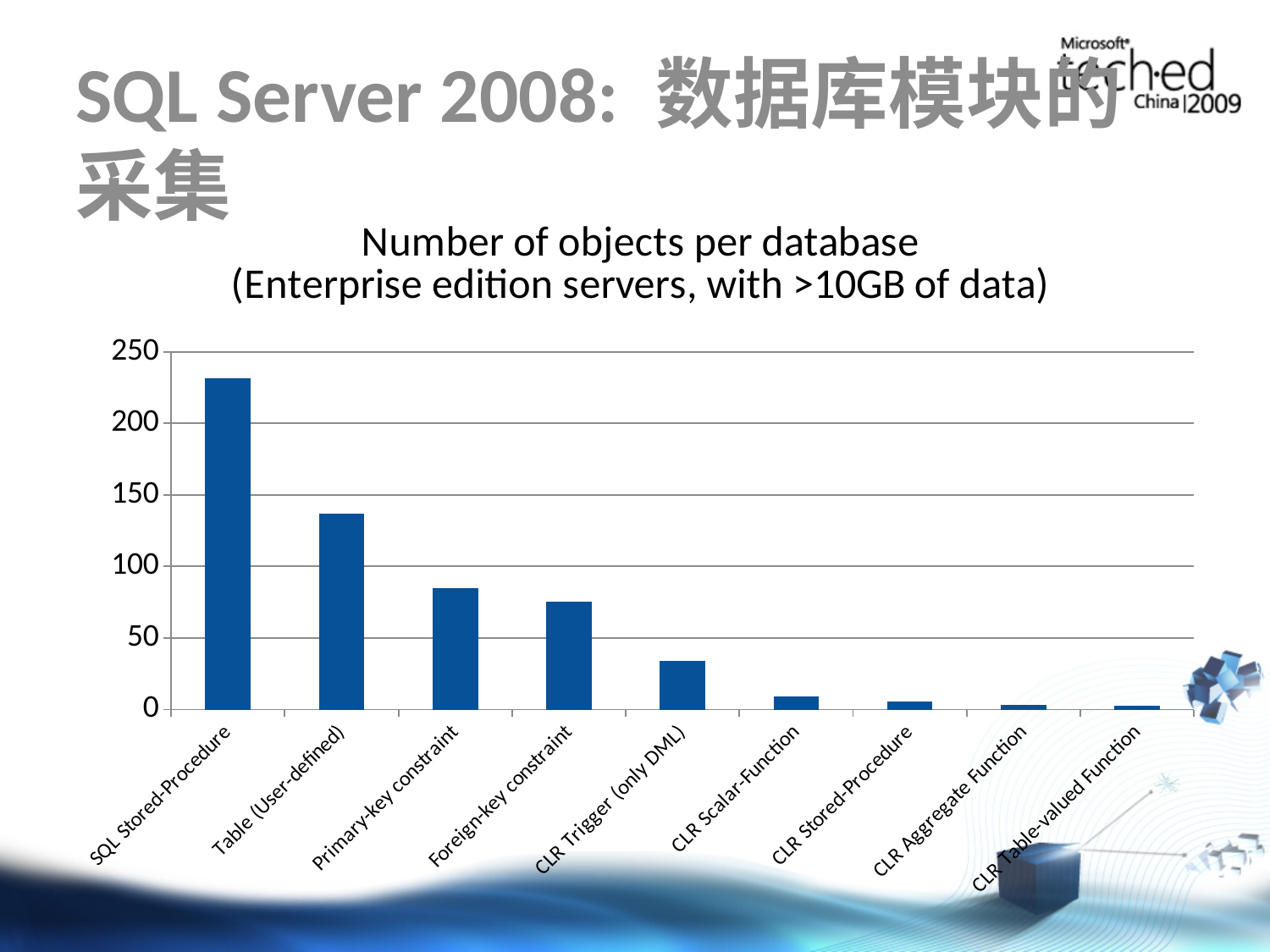
How many categories are plotted on the x axis? 9 Is the value for Table (User-defined) greater or less than 150? less Is the value for SQL Stored-Procedure greater or less than 200? greater Which category has the highest number of objects per database? SQL Stored-Procedure Which is larger, the value for CLR Trigger (only DML) or the value for CLR Scalar-Function? CLR Trigger (only DML) What kind of chart is shown on the slide? bar chart Is the value for Foreign-key constraint greater or less than 50? greater What is the title of the chart? Number of objects per database (Enterprise edition servers, with >10GB of data) Do the values rise or fall moving from left to right along the x axis? fall Which is larger, the value for Table (User-defined) or the value for Primary-key constraint? Table (User-defined)